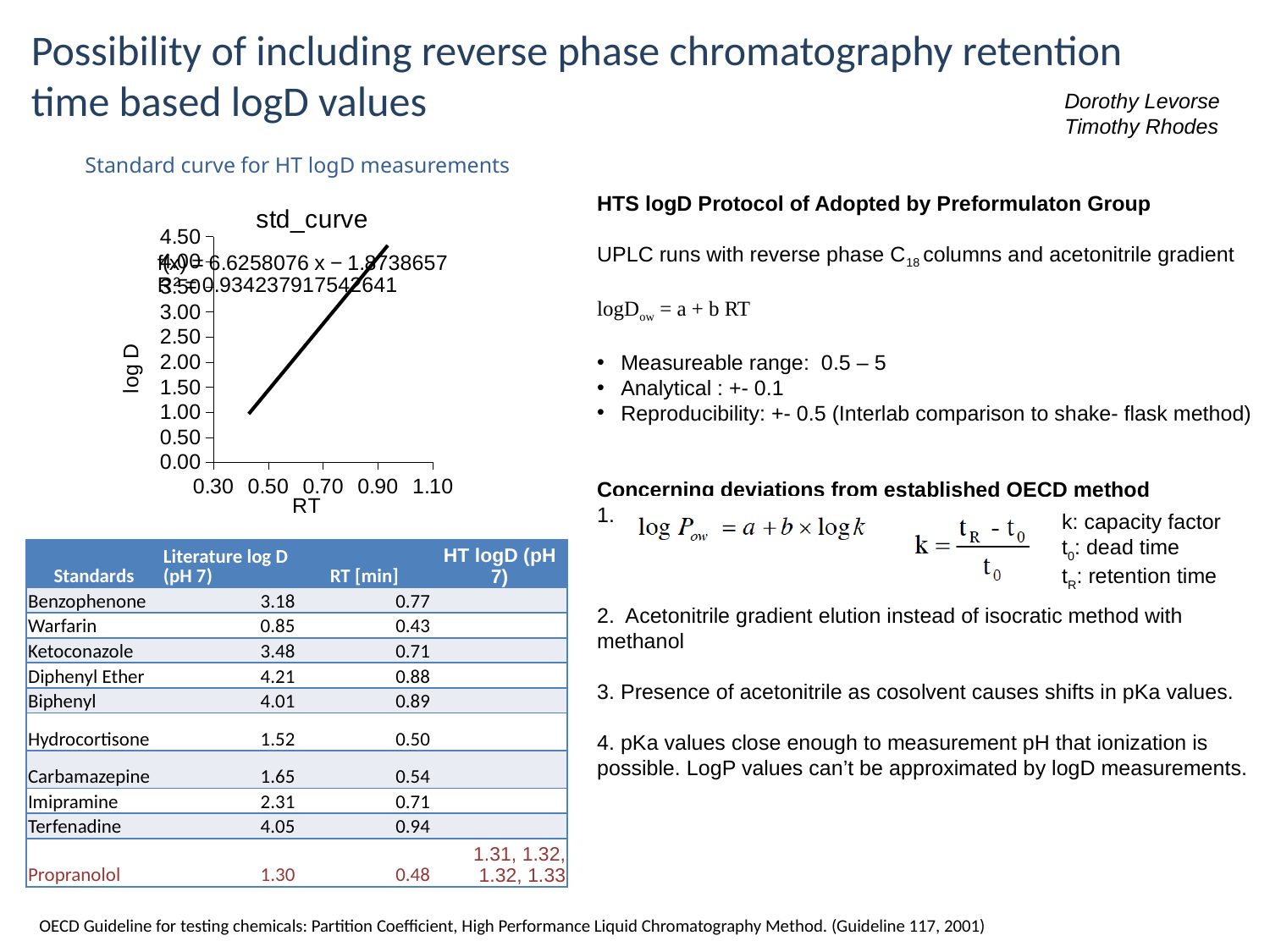
In the std_curve chart, does log D rise or fall as RT increases? rise What kind of chart is the std_curve chart? line chart What is the title of the chart on the slide? std_curve How many tick labels are shown on the x axis of the std_curve chart? 5 In the std_curve chart, is the value of log D at RT 0.50 greater or less than 2.00? less In the std_curve chart, is the value of log D at RT 0.90 greater or less than 3.00? greater What is the highest tick value shown on the y axis of the std_curve chart? 4.50 What is the label of the x axis of the std_curve chart? RT